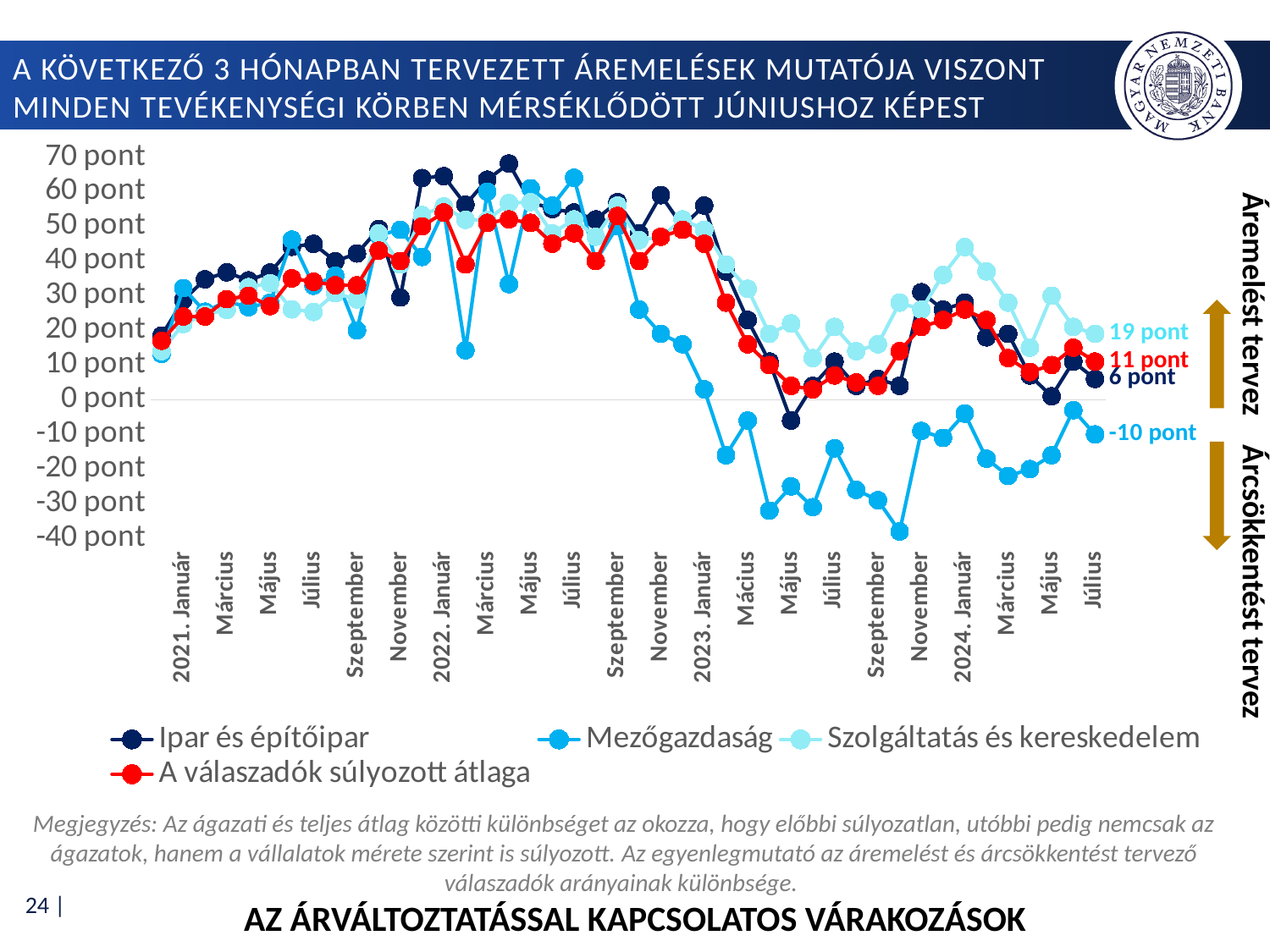
What is the final (2024 Július) value labelled for A válaszadók súlyozott átlaga? 11 pont How many series does the legend list? 4 Which series has the highest value at the end of the chart (2024 Július)? Szolgáltatás és kereskedelem What is the final (2024 Július) value labelled for Szolgáltatás és kereskedelem? 19 pont What kind of chart is shown on the slide? line chart What is the final (2024 Július) value labelled for Mezőgazdaság? -10 pont What is the difference between the final labelled values of Szolgáltatás és kereskedelem and Mezőgazdaság? 29 pont Does the Mezőgazdaság series rise or fall between 2023. Január and 2023 Május? fall At the end of the chart, which is larger: the value for Ipar és építőipar or for A válaszadók súlyozott átlaga? A válaszadók súlyozott átlaga What is the final (2024 Július) value labelled for Ipar és építőipar? 6 pont Is the value for Mezőgazdaság in 2023 Május greater or less than -20 pont? less Which series has the lowest value at the end of the chart (2024 Július)? Mezőgazdaság